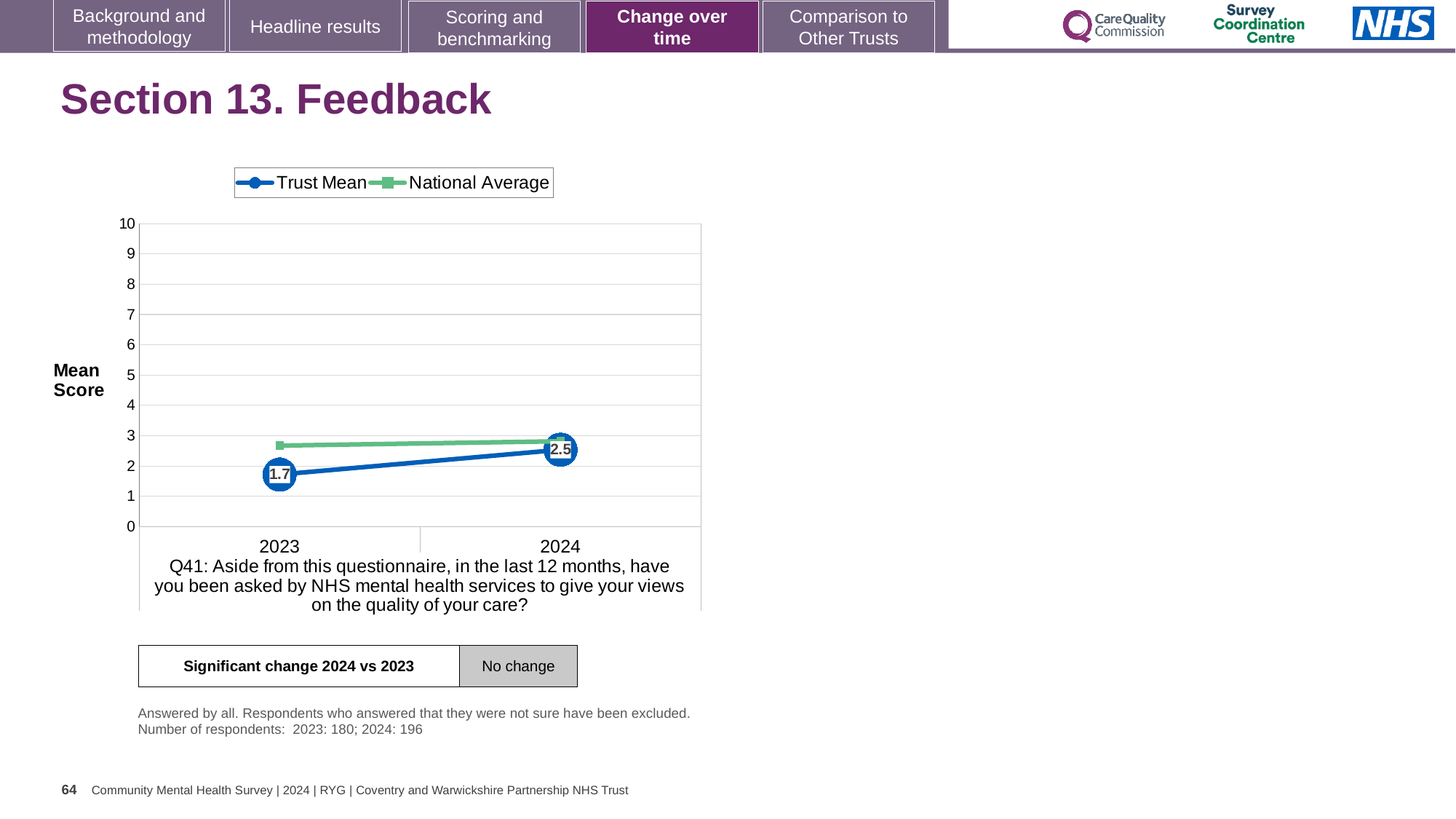
How many years are plotted on the x axis? 2 By how much did the Trust Mean change from 2023 to 2024? 0.8 How many series does the legend list? 2 What kind of chart is shown on the slide? line chart What does the 'Significant change 2024 vs 2023' box say? No change Which year has the higher Trust Mean, 2023 or 2024? 2024 What are the two series named in the legend? Trust Mean and National Average In 2023, which is higher, the Trust Mean or the National Average? National Average What is the Trust Mean value for 2023? 1.7 What is the Trust Mean value for 2024? 2.5 Does the Trust Mean rise or fall from 2023 to 2024? rise Is the National Average value for 2023 greater or less than 2? greater